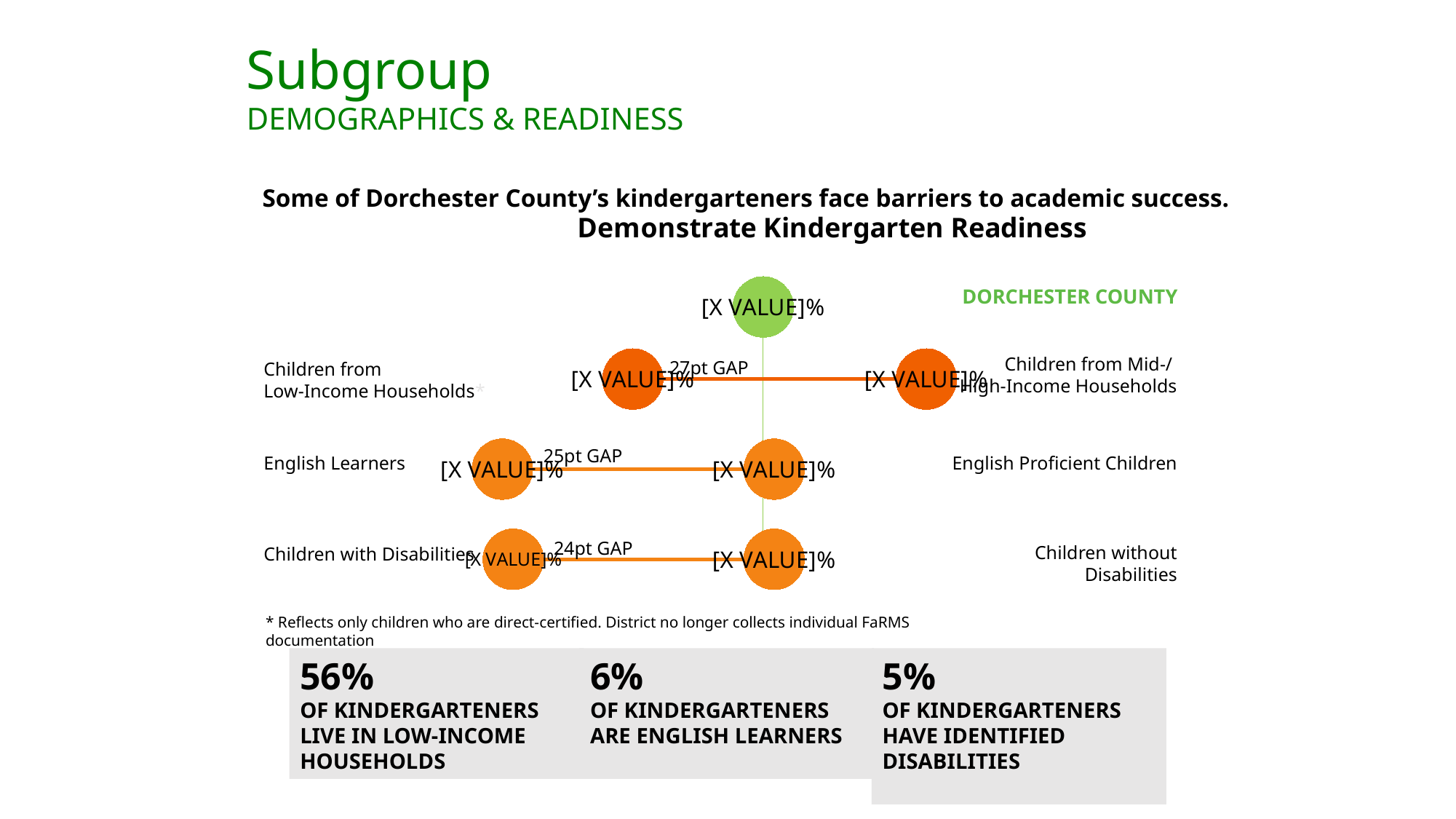
What colour are the dots for Children from Low-Income Households and Children from Mid-/High-Income Households? Dark orange How much larger is the low-income gap than the disabilities gap? 3pt What is the gap shown between English Learners and English Proficient Children? 25pt GAP How many subgroup pairs are compared in the chart? 3 What label is shown next to the green dot at the top of the chart? DORCHESTER COUNTY How much larger is the low-income gap than the English learners gap? 2pt Which subgroup comparison shows the largest readiness gap? Children from Low-Income Households vs Children from Mid-/High-Income Households (27pt GAP) Which subgroup comparison shows the smallest readiness gap? Children with Disabilities vs Children without Disabilities (24pt GAP) What is the gap shown between Children with Disabilities and Children without Disabilities? 24pt GAP Which group has the higher kindergarten readiness rate: Children with Disabilities or Children without Disabilities? Children without Disabilities What is the gap shown between Children from Low-Income Households and Children from Mid-/High-Income Households? 27pt GAP Which group has the higher kindergarten readiness rate: English Learners or English Proficient Children? English Proficient Children